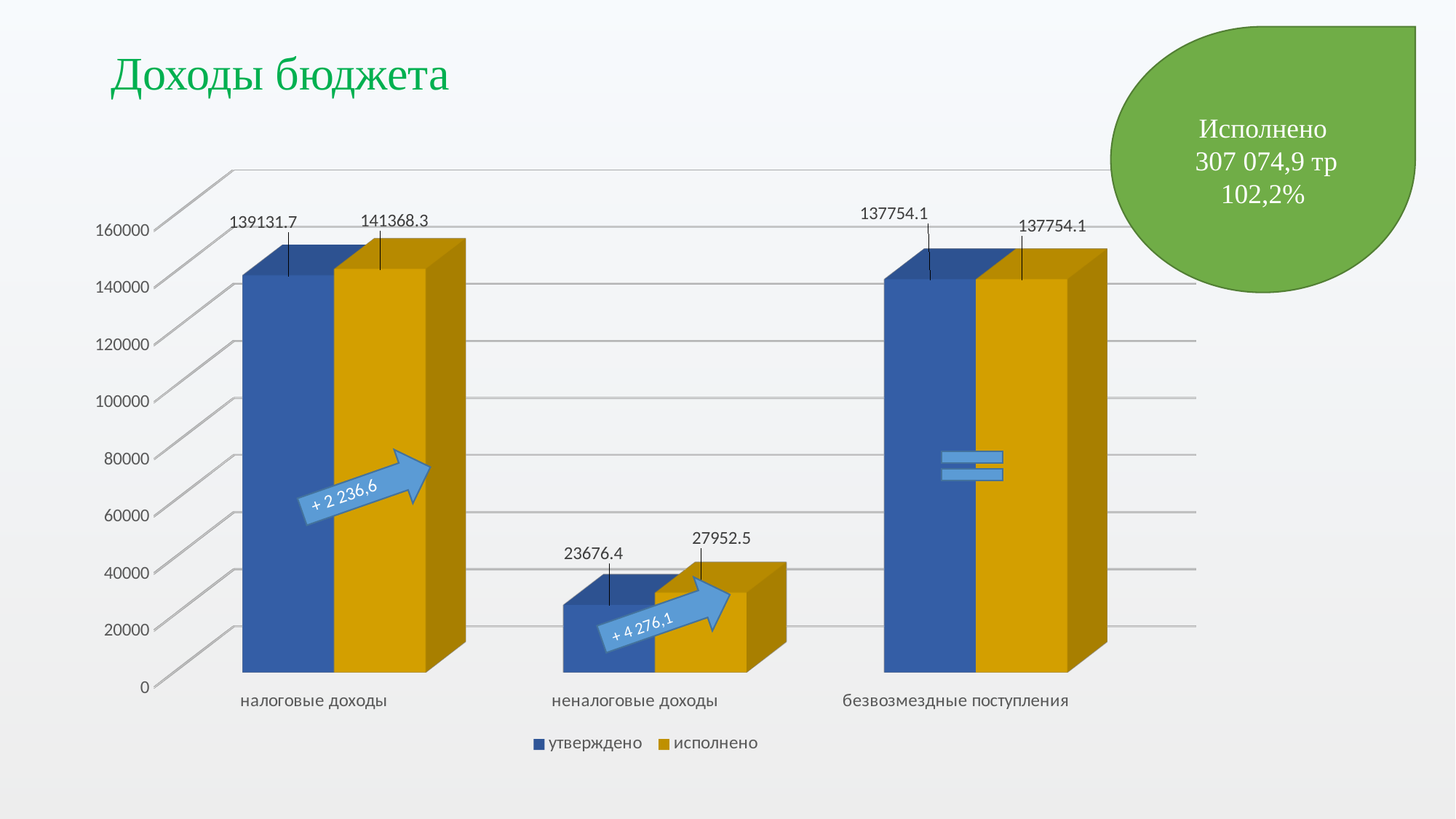
What type of chart is shown on the slide? bar chart What is the исполнено value for безвозмездные поступления? 137754.1 What is the исполнено value for неналоговые доходы? 27952.5 Which category has the lowest исполнено value? неналоговые доходы What is the утверждено value for неналоговые доходы? 23676.4 Which category has the highest исполнено value? налоговые доходы How many series does the chart legend list? 2 How many categories are shown on the x axis of the chart? 3 Which is larger for налоговые доходы: the утверждено value or the исполнено value? исполнено What is the утверждено value for налоговые доходы? 139131.7 What is the difference between the исполнено and утверждено values for неналоговые доходы? 4276.1 What is the исполнено value for налоговые доходы? 141368.3